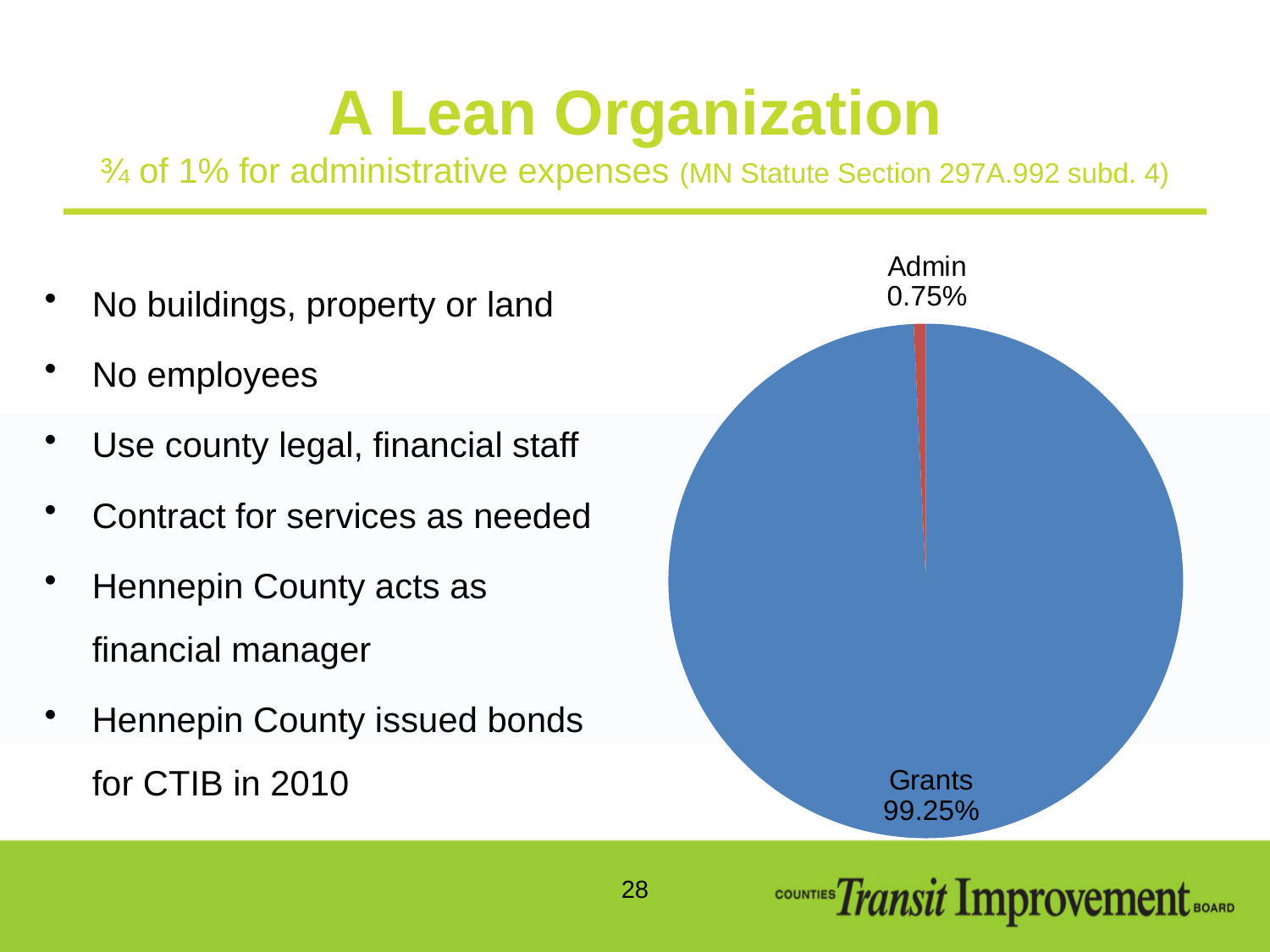
How many slices does the pie chart have? 2 Which slice of the pie is the largest? Grants Which slice of the pie is the smallest? Admin What share of the pie does Grants represent? 99.25% What kind of chart is shown on the slide? pie chart Which is larger, the Grants slice or the Admin slice? Grants What colour is the Admin slice of the pie? red What is the difference in percentage points between the Grants slice and the Admin slice? 98.5 What share of the pie does Admin represent? 0.75% What colour is the Grants slice of the pie? blue